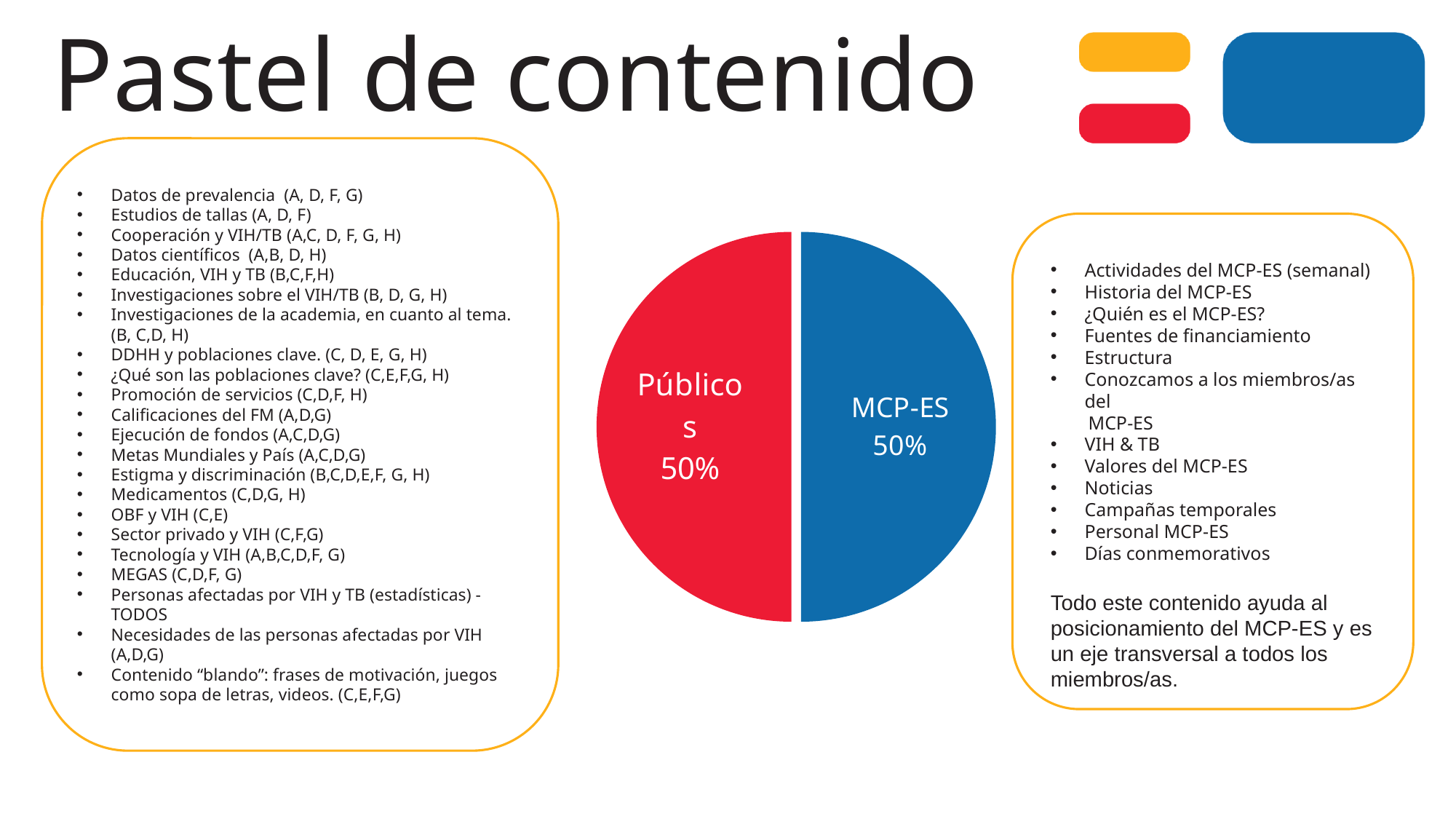
What share of the pie does the Públicos slice represent? 50% What is the difference between the Públicos and MCP-ES slices? 0% How many slices does the pie chart have? 2 What is the value shown for the MCP-ES slice? 50% What is the value shown for the Públicos slice? 50% What share of the pie does the MCP-ES slice represent? 50% What colour is the MCP-ES slice? blue What kind of chart is shown on the slide? pie chart What colour is the Públicos slice? red